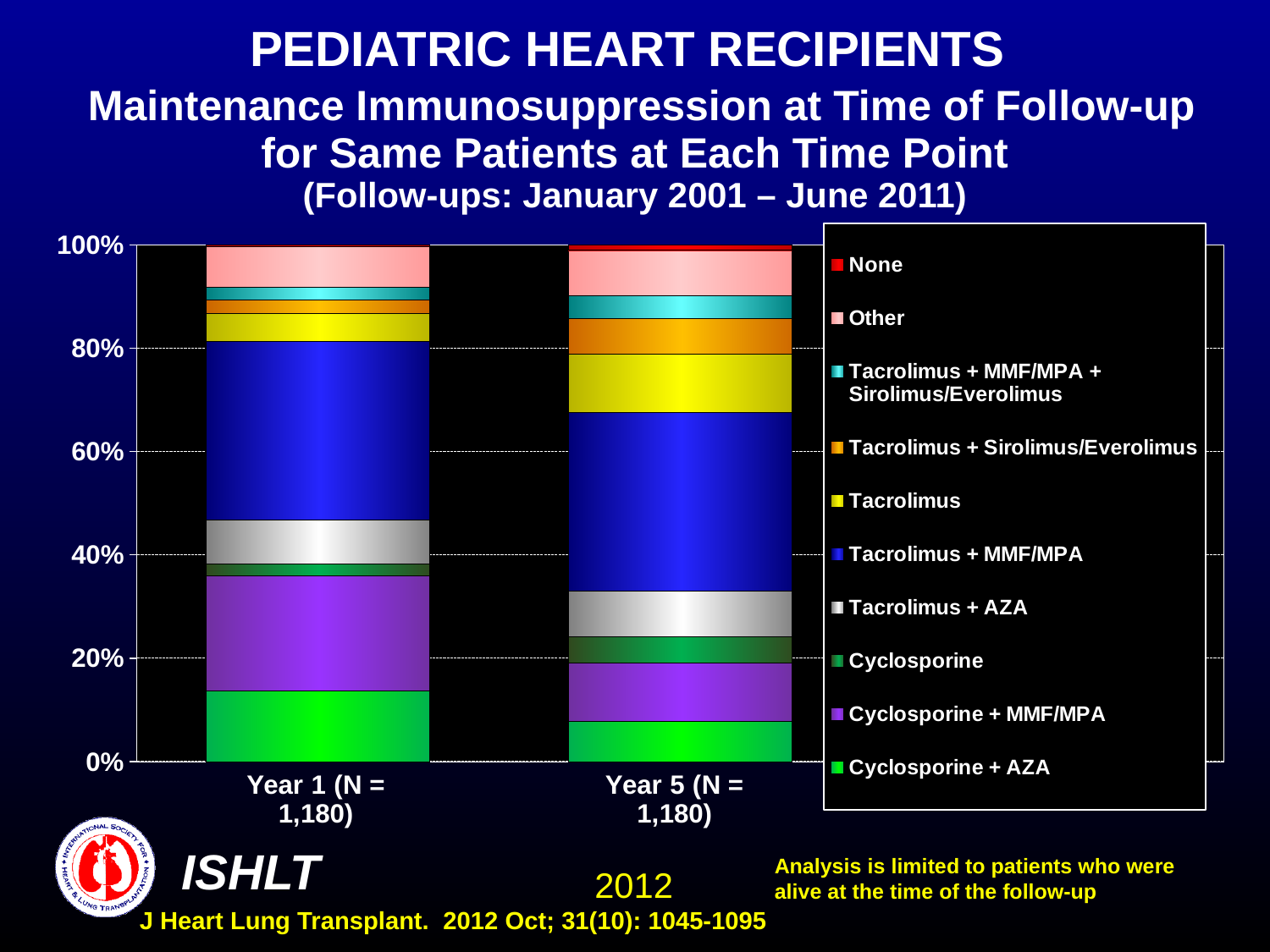
Does the Cyclosporine + AZA share rise or fall from Year 1 to Year 5? Fall Is the Tacrolimus + MMF/MPA share in the Year 5 bar greater or less than 20%? greater Which legend entry is listed first (at the top) of the legend? None Which regimen makes up the largest segment of the Year 1 bar? Tacrolimus + MMF/MPA Is the Tacrolimus (alone) share larger at Year 1 or at Year 5? Year 5 Which regimen makes up the largest segment of the Year 5 bar? Tacrolimus + MMF/MPA How many series does the legend list? 10 What kind of chart is shown on the slide? Stacked bar chart Is the Cyclosporine + MMF/MPA share larger at Year 1 or at Year 5? Year 1 What are the two category labels on the x axis? Year 1 (N = 1,180) and Year 5 (N = 1,180) How many bars (time points) are plotted on the chart? 2 Is the Cyclosporine + AZA share in the Year 1 bar greater or less than 20%? less